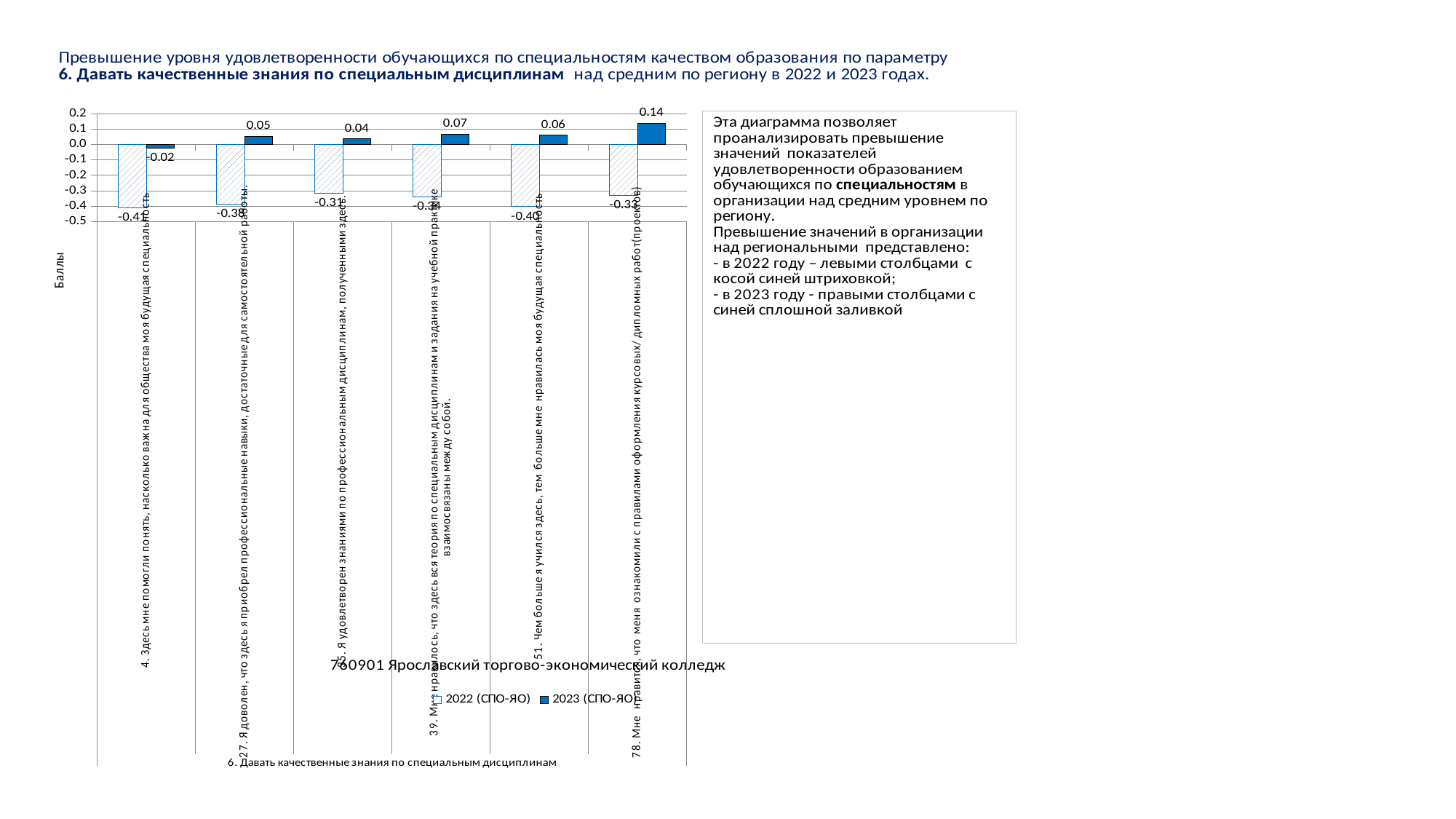
How many categories (survey items) are plotted on the chart? 6 What is the difference between the 2023 and 2022 values for item 27 (приобрел профессиональные навыки)? 0.43 Which item has the highest 2023 (СПО-ЯО) value? 78. Мне нравится, что меня ознакомили с правилами оформления курсовых/дипломных работ(проектов) Is the 2022 (СПО-ЯО) value for item 51 (чем больше я учился здесь) greater or less than -0.3? less What is the 2023 (СПО-ЯО) value for item 78 (ознакомили с правилами оформления курсовых/дипломных работ)? 0.14 What kind of chart is shown on the slide? bar chart What is the 2022 (СПО-ЯО) value for item 27 (приобрел профессиональные навыки, достаточные для самостоятельной работы)? -0.38 Which item has the lowest 2023 (СПО-ЯО) value? 4. Здесь мне помогли понять, насколько важна для общества моя будущая специальность How many series does the chart legend list? 2 What are the two legend entries of the chart? 2022 (СПО-ЯО) and 2023 (СПО-ЯО) What is the 2023 (СПО-ЯО) value for item 4 (помогли понять, насколько важна для общества моя будущая специальность)? -0.02